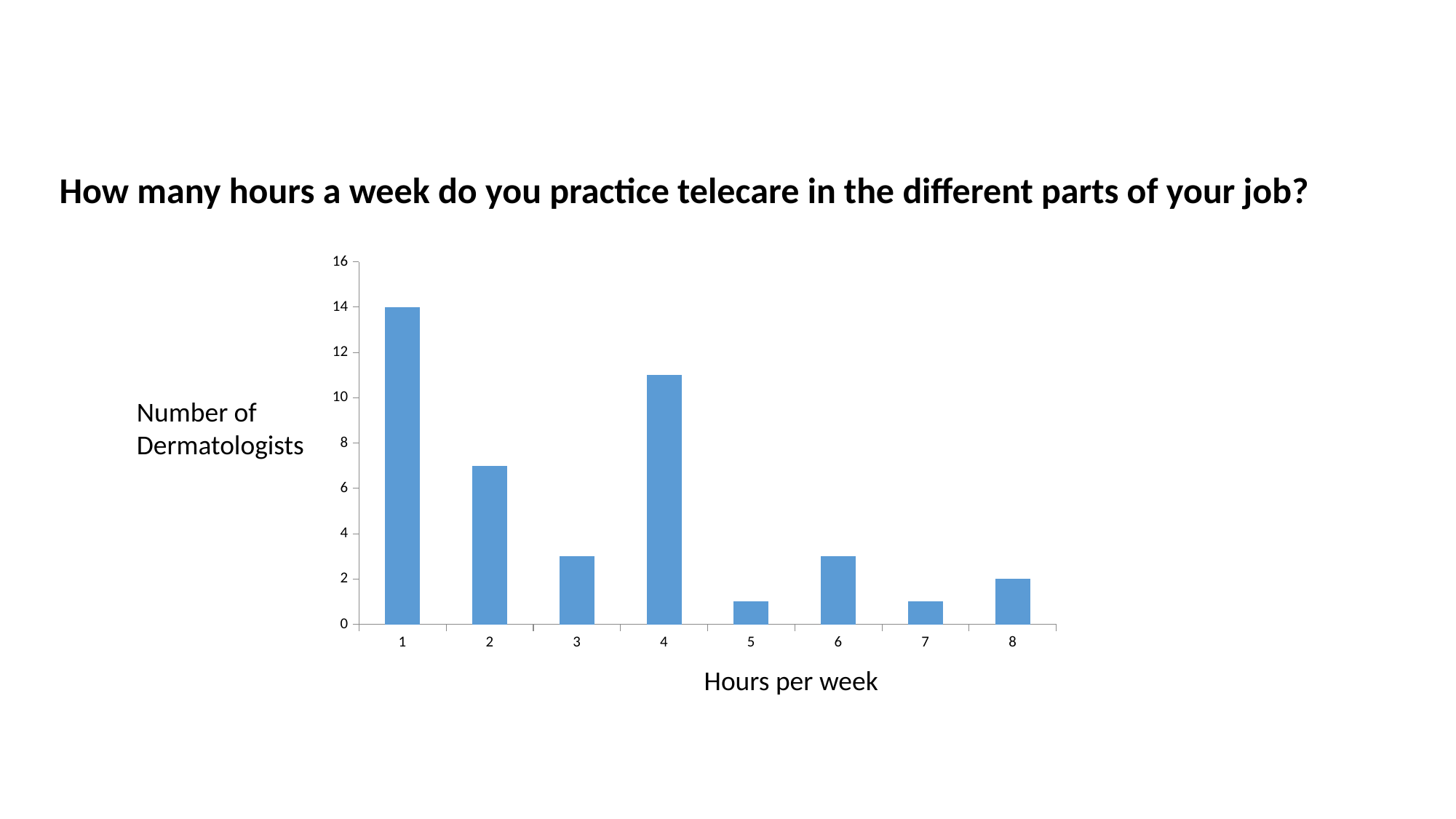
Is the number of dermatologists for 2 hours per week greater or less than 8? less Is the number of dermatologists for 4 hours per week greater or less than 10? greater What is the difference between the number of dermatologists at 1 hour per week and at 8 hours per week? 12 How many hours-per-week categories are shown on the x axis? 8 What is the label of the x axis? Hours per week What is the label of the y axis? Number of Dermatologists How many dermatologists practice telecare 1 hour per week? 14 Is the number of dermatologists for 3 hours per week greater or less than 4? less Which has more dermatologists: 4 hours per week or 2 hours per week? 4 hours per week What type of chart is shown on the slide? Bar chart Which hours-per-week category has the highest number of dermatologists? 1 How many dermatologists practice telecare 8 hours per week? 2